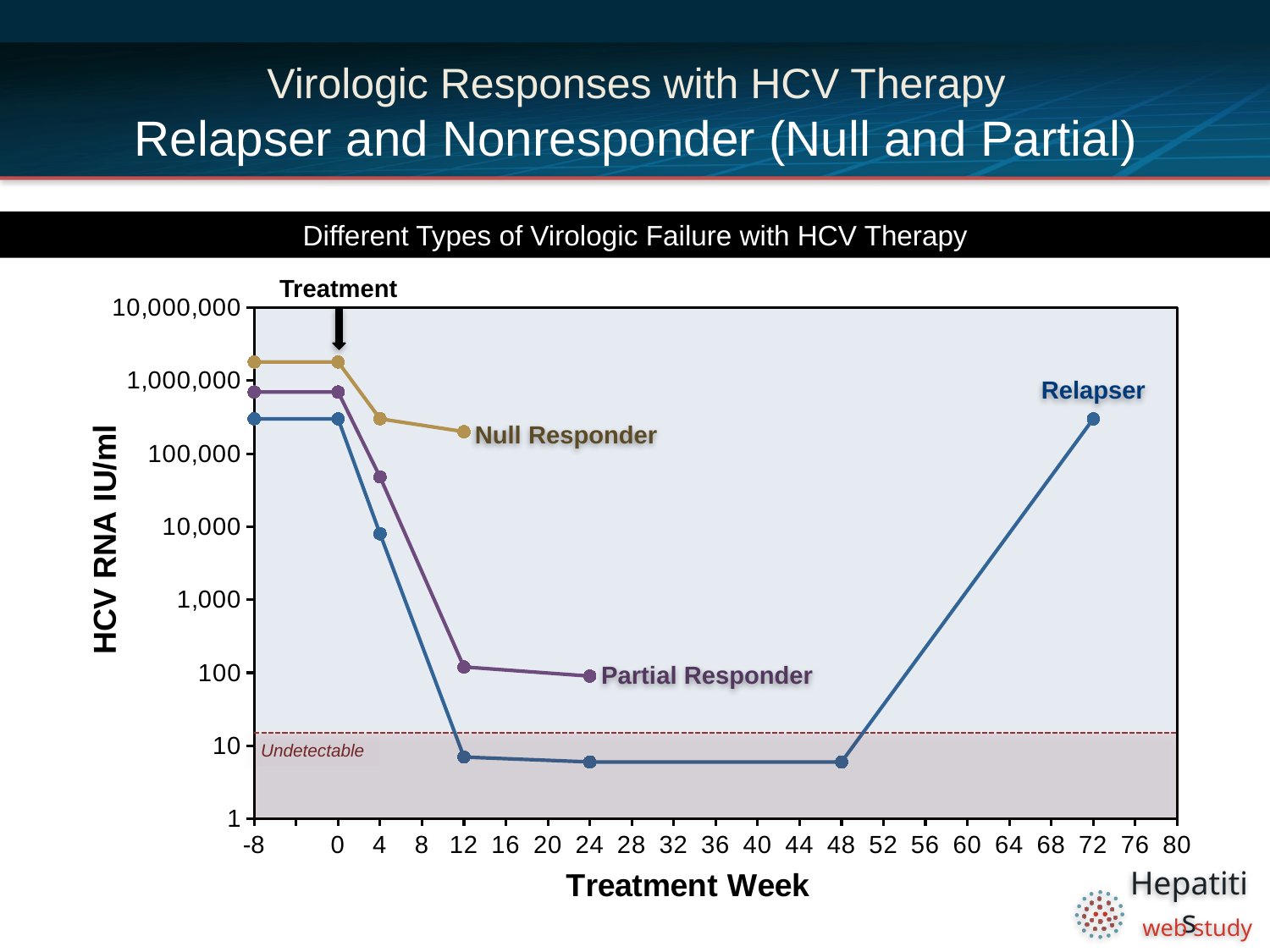
How many data points are plotted for the Null Responder series? 4 Is the Relapser value at treatment week 72 greater or less than 100,000? greater Does the Relapser line rise or fall between treatment week 48 and week 72? rise Which series has the highest HCV RNA value at treatment week 4? Null Responder Is the Partial Responder value at treatment week 24 greater or less than 1,000? less What is the title of the y axis? HCV RNA IU/ml What kind of chart is shown on the slide? line chart Which series has the lowest HCV RNA value at treatment week 12? Relapser How many series are labeled on the chart? 3 Is the Relapser value at treatment week 12 greater or less than 10? less